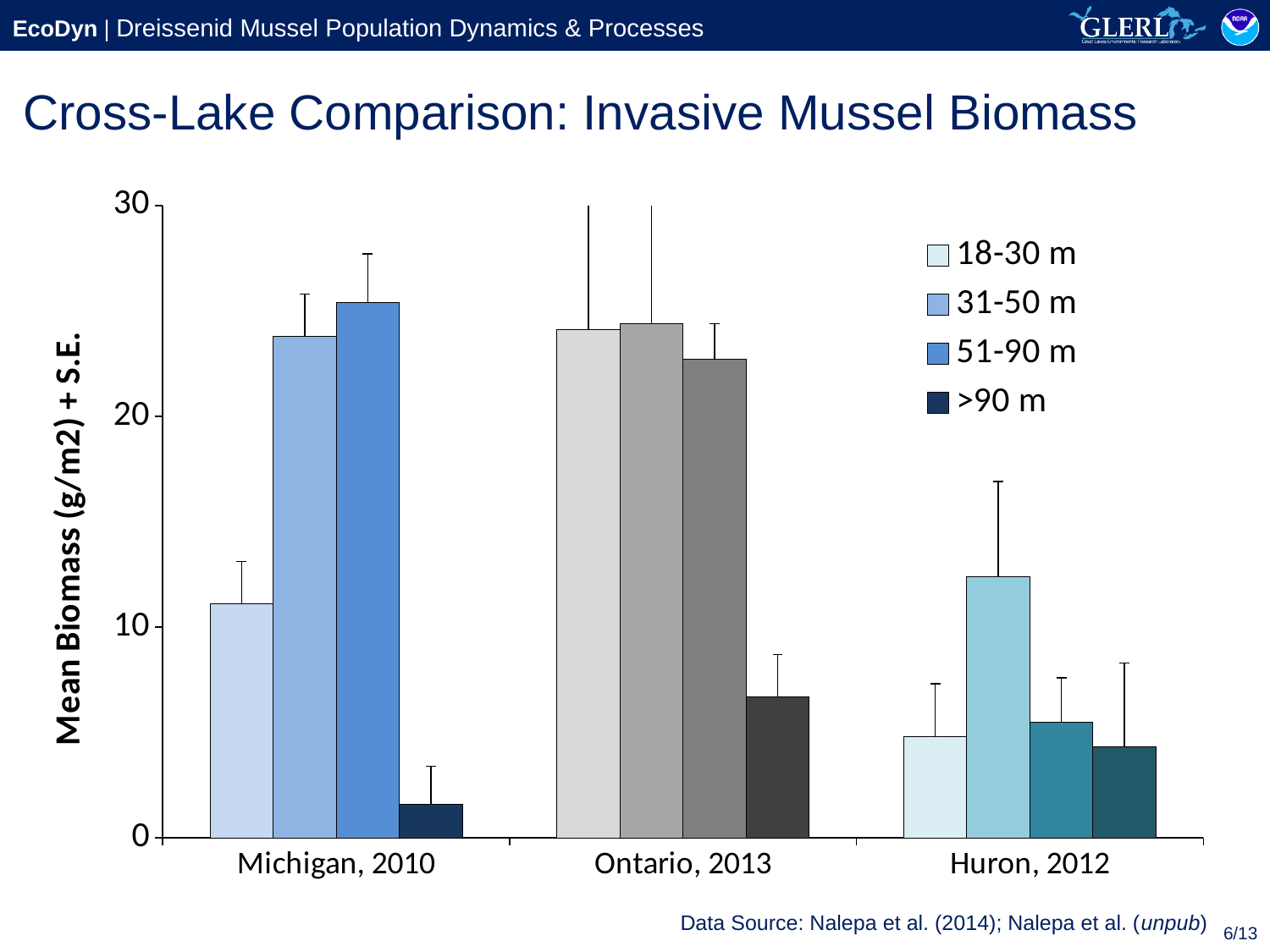
For the >90 m depth, which lake has the larger mean biomass: Michigan, 2010 or Ontario, 2013? Ontario, 2013 Is the mean biomass for the 51-90 m depth in Michigan, 2010 greater or less than 20? greater Is the mean biomass for the 31-50 m depth in Huron, 2012 greater or less than 10? greater Which depth range has the highest mean biomass in Huron, 2012? 31-50 m What is the label of the y axis? Mean Biomass (g/m2) + S.E. How many lake groups are shown along the x axis? 3 Which depth range has the lowest mean biomass in Ontario, 2013? >90 m Is the mean biomass for the 18-30 m depth in Michigan, 2010 greater or less than 10? greater How many depth ranges does the legend list? 4 What kind of chart is shown on the slide? bar chart Which depth range has the lowest mean biomass in Michigan, 2010? >90 m